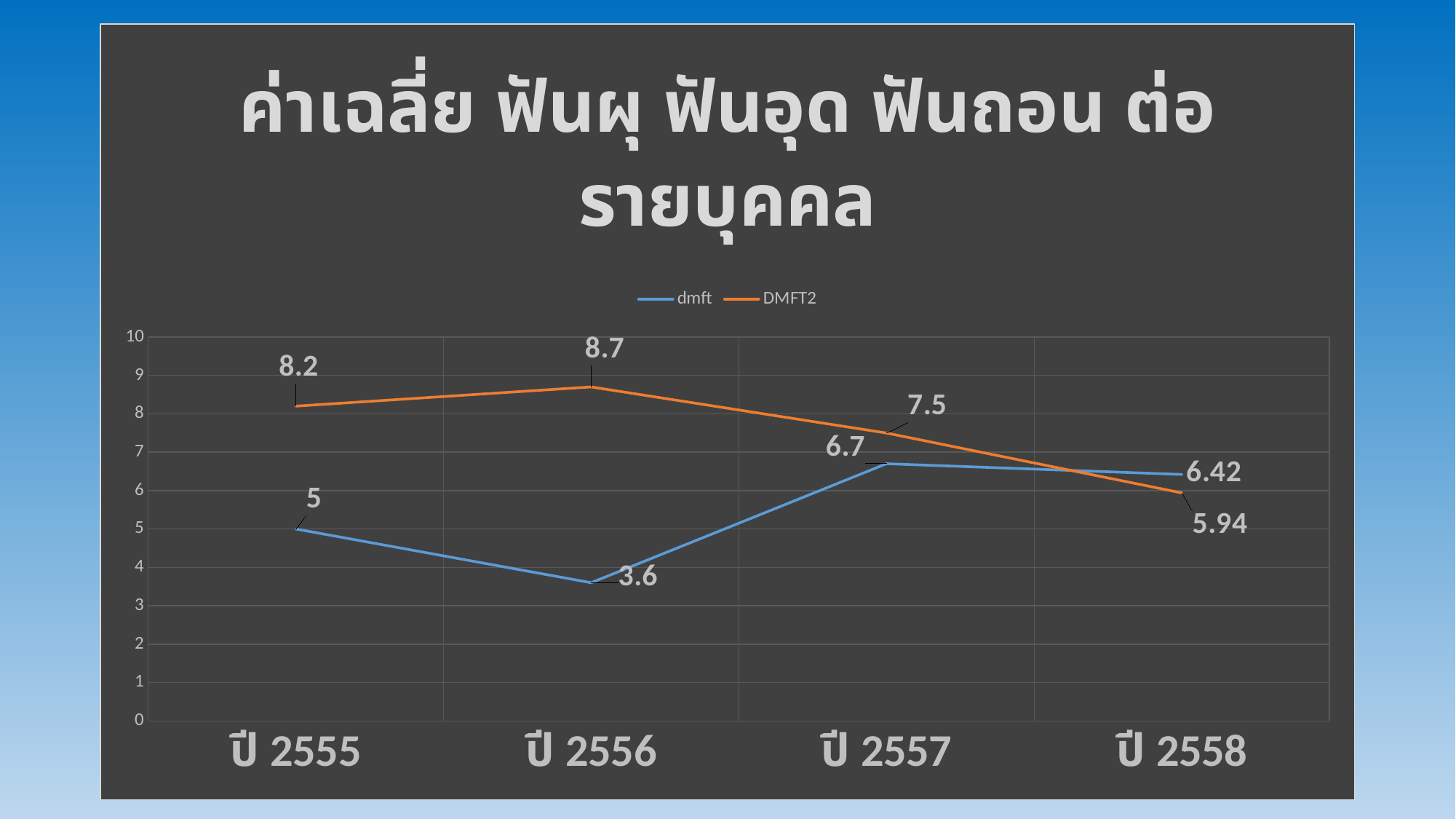
What is the DMFT2 value for ปี 2558? 5.94 Which series is drawn in orange? DMFT2 How many years are shown on the x axis? 4 What type of chart is shown on the slide? line chart In which year is dmft lowest? ปี 2556 Which is larger in ปี 2558, dmft or DMFT2? dmft In which year is DMFT2 highest? ปี 2556 How many series does the legend list? 2 Does DMFT2 rise or fall from ปี 2556 to ปี 2558? fall What is the dmft value for ปี 2556? 3.6 What is the difference between DMFT2 and dmft in ปี 2555? 3.2 What is the dmft value for ปี 2555? 5